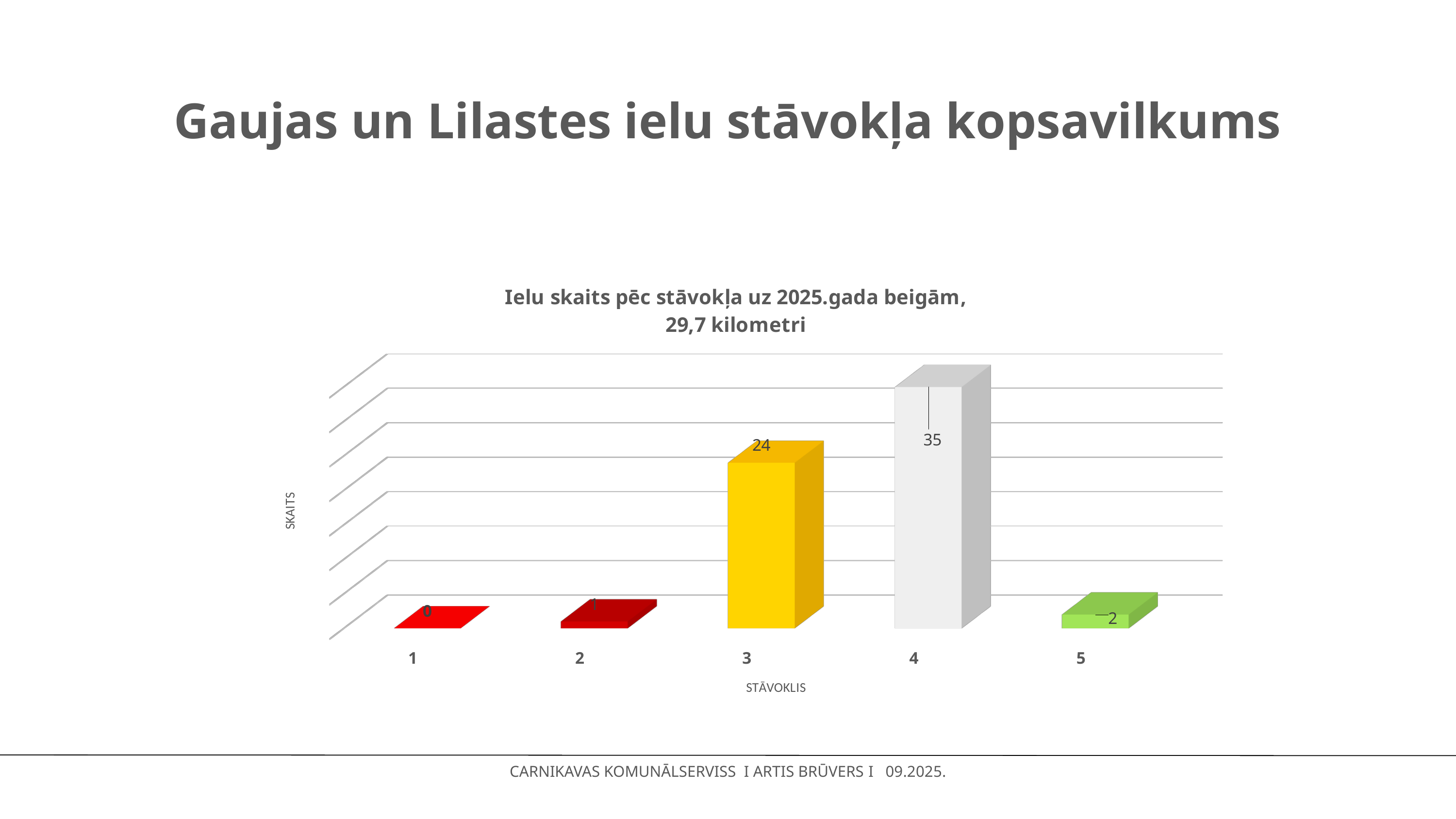
What is the value for category 1? 0 What kind of chart is shown on the slide? bar chart Which category has the highest value? 4 What is the difference between the values for category 4 and category 3? 11 Which category has the lowest value? 1 Which is larger, the value for category 3 or the value for category 5? category 3 What is the title of the chart? Ielu skaits pēc stāvokļa uz 2025.gada beigām, 29,7 kilometri What is the label of the x axis? STĀVOKLIS What is the value for category 4? 35 What is the value for category 3? 24 How many categories are shown on the x axis? 5 What is the value for category 5? 2